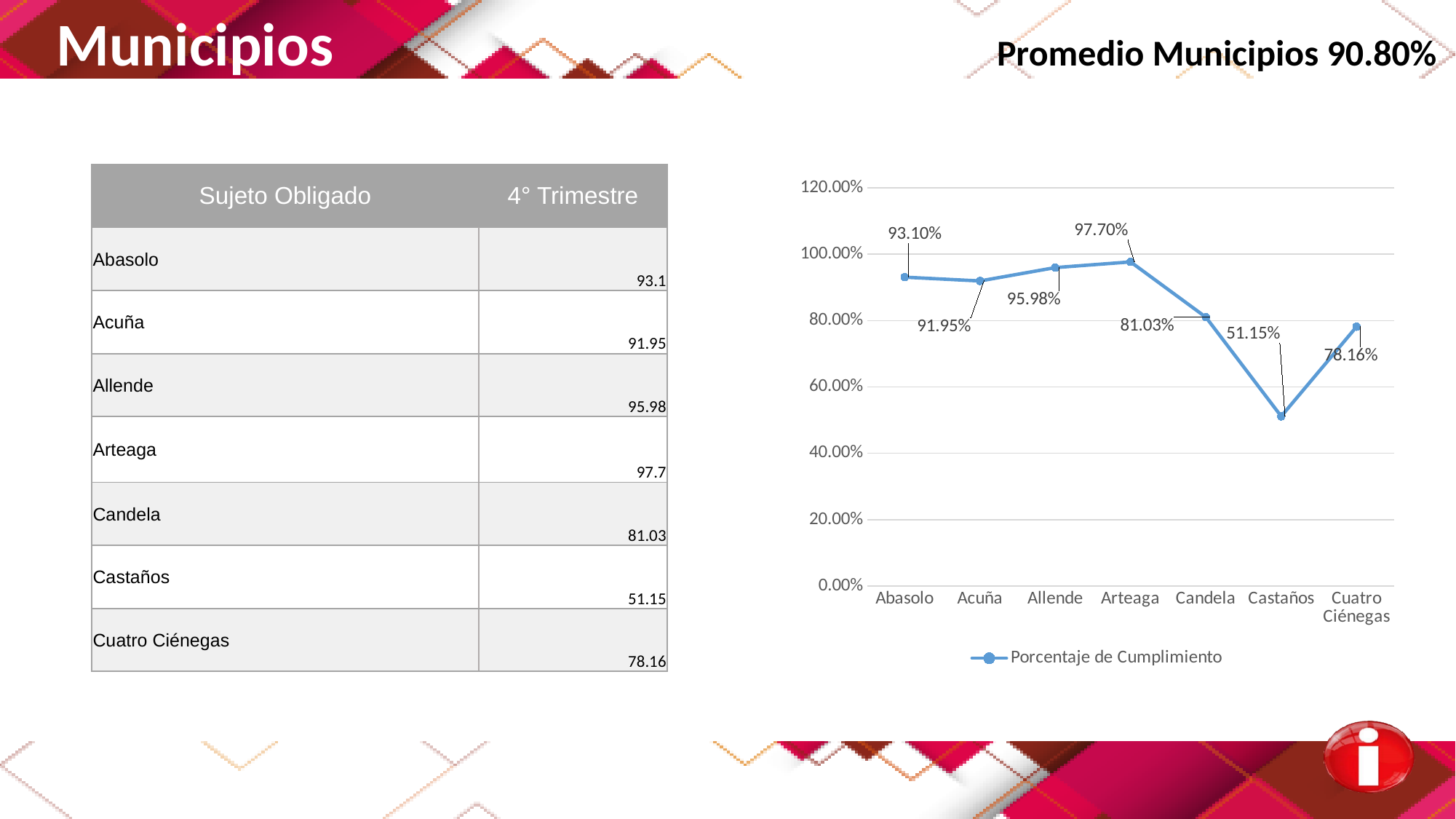
What is the name of the series shown in the chart legend? Porcentaje de Cumplimiento What kind of chart is shown on the slide? line chart Which has a larger value, Candela or Cuatro Ciénegas? Candela How many series does the chart legend list? 1 What is the value for Castaños in the chart? 51.15% What is the value for Cuatro Ciénegas in the chart? 78.16% What is the value for Arteaga in the chart? 97.70% What is the difference between the values for Arteaga and Castaños? 46.55% How many categories are plotted on the x axis of the chart? 7 Is the value for Castaños greater or less than 60.00%? less Which category has the lowest value in the chart? Castaños Which category has the highest value in the chart? Arteaga